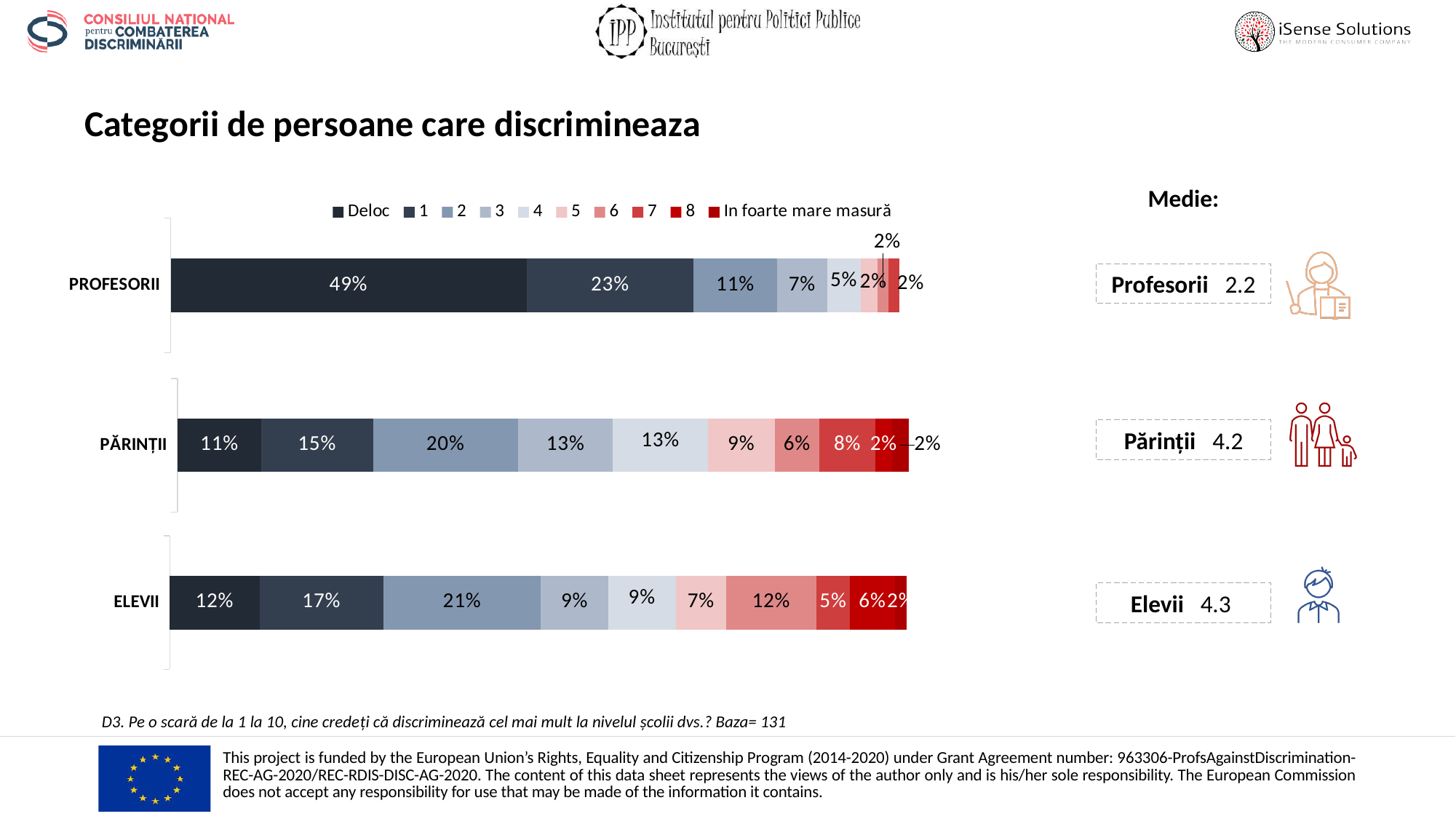
What kind of chart is shown on the slide? Stacked bar chart What is the difference in percentage points between the "Deloc" share for PROFESORII and for PĂRINȚII? 38 percentage points What is the average (Medie) shown for Elevii? 4.3 Which category has the highest "Deloc" share? PROFESORII What percentage of respondents answered "Deloc" for PROFESORII? 49% What is the value of the "7" segment for PĂRINȚII? 8% What is the value of the "2" segment for ELEVII? 21% How many categories are shown on the chart? 3 Which category has the lowest "Deloc" share? PĂRINȚII How many series does the legend list? 10 What is the value of the "6" segment for ELEVII? 12% Which is larger: the "1" segment for PĂRINȚII or the "1" segment for ELEVII? ELEVII